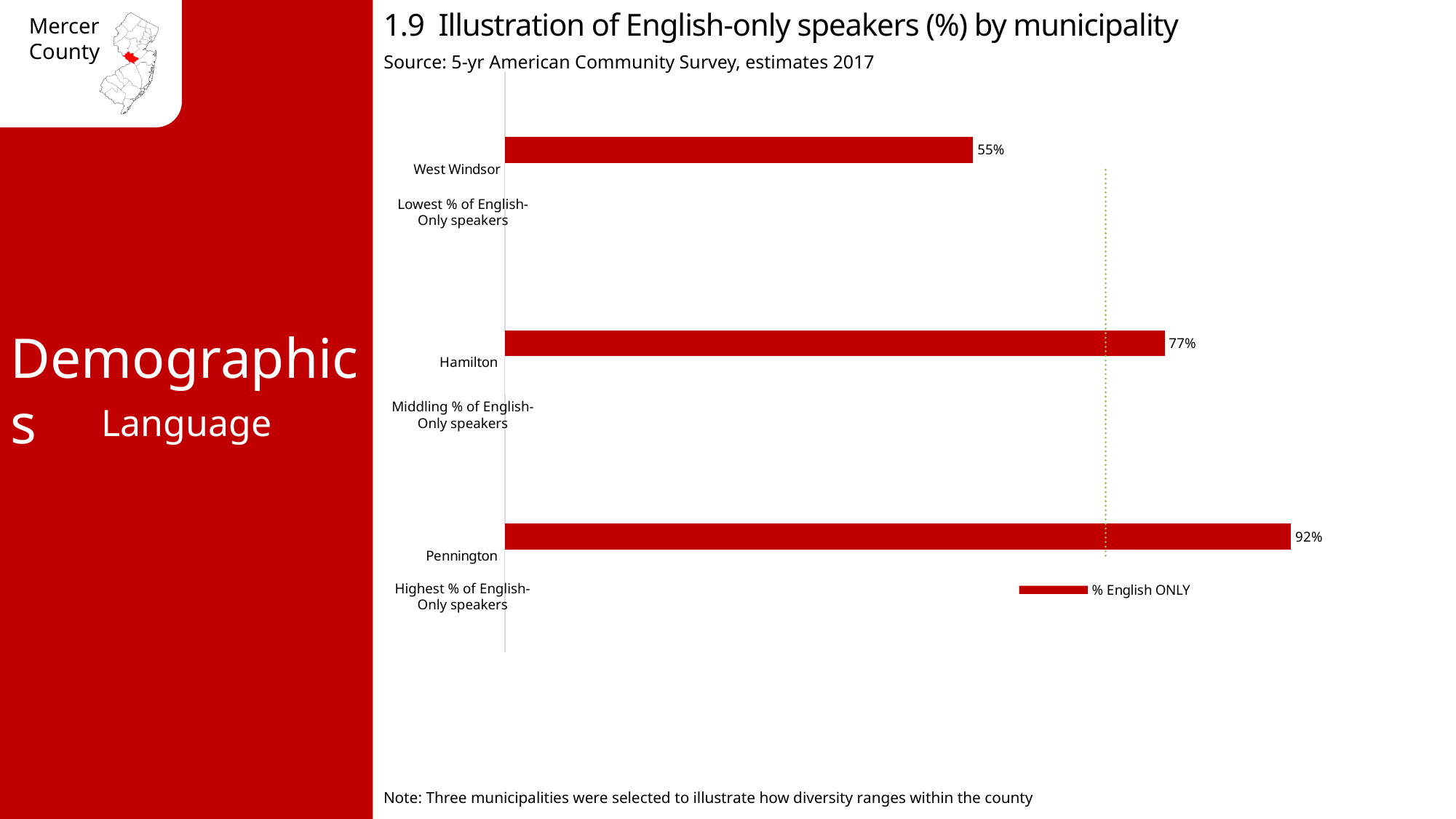
What is the percentage of English-only speakers in Hamilton? 77% Which municipality has the lowest percentage of English-only speakers? West Windsor What is the percentage of English-only speakers in West Windsor? 55% Which has a higher percentage of English-only speakers, Hamilton or West Windsor? Hamilton How many municipalities are shown in the chart? 3 What is the percentage of English-only speakers in Pennington? 92% What is the legend entry for the series shown in the chart? % English ONLY Which municipality has the highest percentage of English-only speakers? Pennington What is the difference in percentage points between Pennington and West Windsor? 37 How many series does the legend list? 1 What type of chart is shown on the slide? Bar chart What is the difference in percentage points between Hamilton and West Windsor? 22